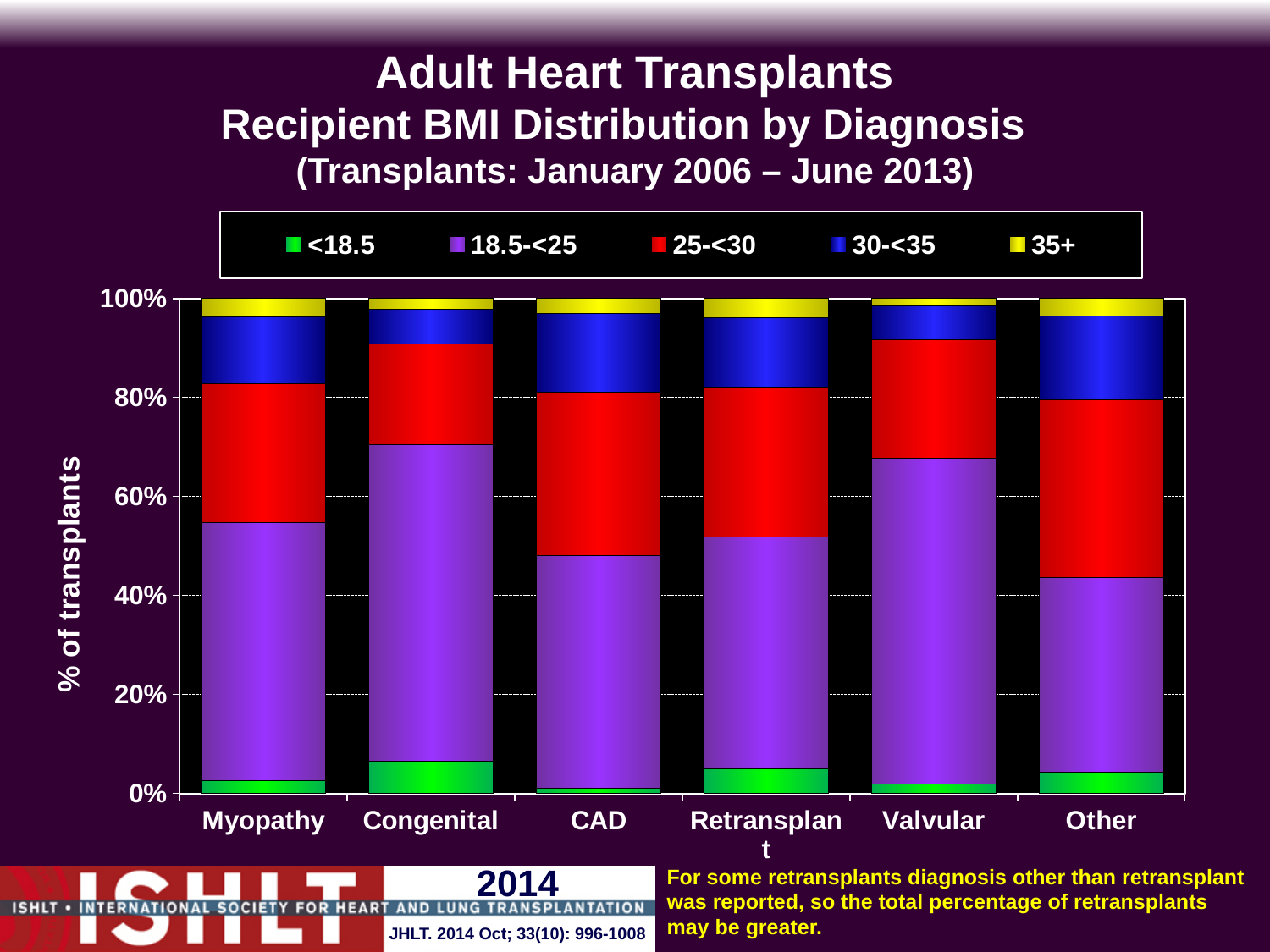
Is the 25-<30 share for Other greater or less than 20%? greater Is the 18.5-<25 share for Myopathy greater or less than 40%? greater Which has the larger 30-<35 share, CAD or Congenital? CAD Is the 18.5-<25 share for Valvular greater or less than 60%? greater What kind of chart is shown on the slide? Stacked bar chart How many BMI series does the legend list? 5 Which has the larger <18.5 share, Congenital or CAD? Congenital Which has the larger 18.5-<25 share, Valvular or Other? Valvular How many diagnosis categories are shown on the x axis? 6 Which BMI category does the legend list first? <18.5 What is the label of the y axis? % of transplants